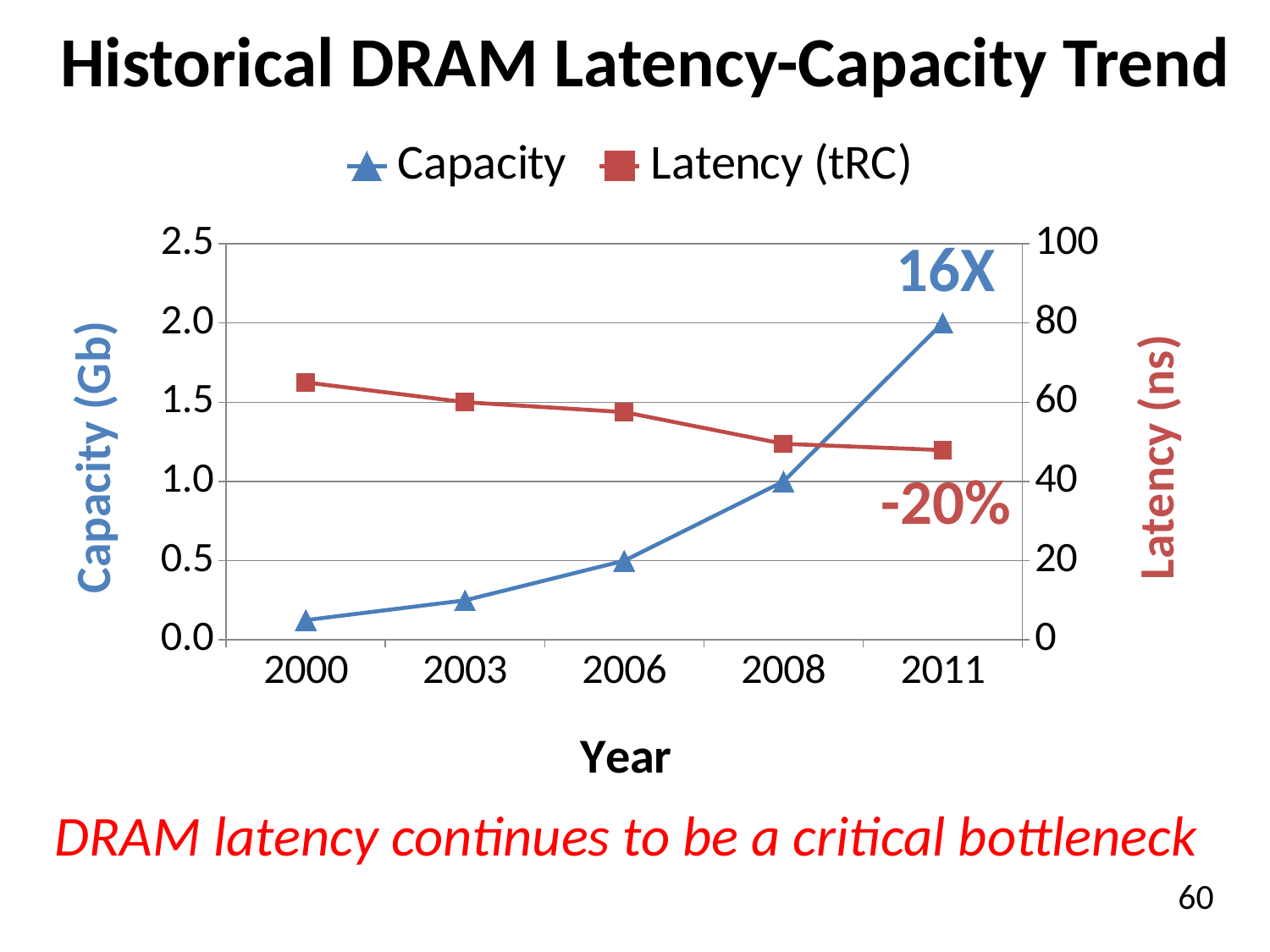
Is the Latency (tRC) value for 2000 greater or less than 60? greater How many years are plotted along the x axis? 5 Which year has the highest Capacity? 2011 How many series does the legend list? 2 Is the Latency (tRC) value for 2011 greater or less than 60? less What is the Capacity value for 2011? 2.0 Which year has the highest Latency (tRC)? 2000 Which year has the lowest Capacity? 2000 Does Latency (tRC) rise or fall from 2000 to 2011? fall What is the Capacity value for 2008? 1.0 What kind of chart is shown on the slide? line chart Does Capacity rise or fall from 2000 to 2011? rise